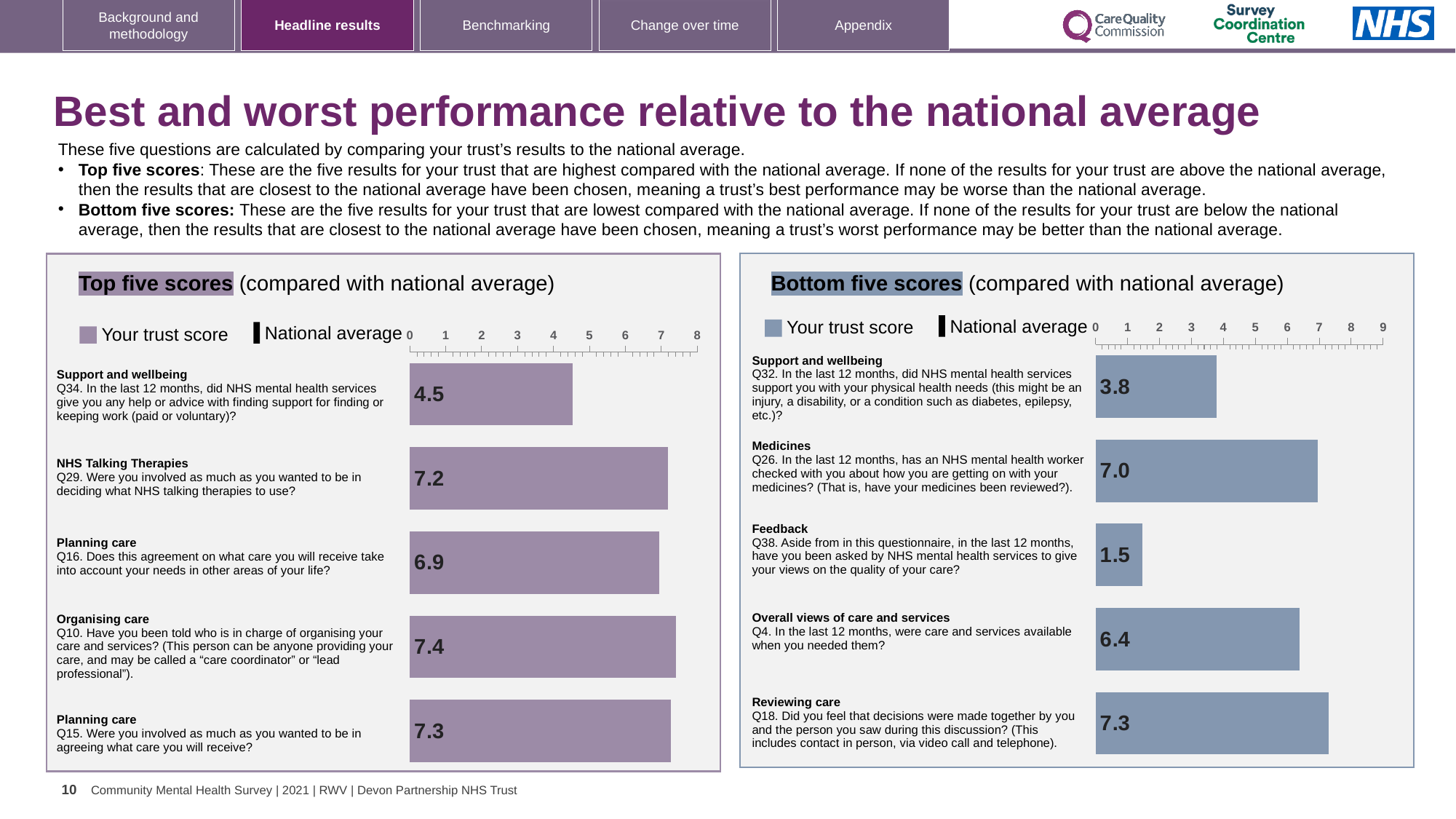
In the Top five scores chart, which question has the lowest trust score? Q34 (Support and wellbeing) In the Bottom five scores chart, which question has the highest trust score? Q18 (Reviewing care) What type of chart is the Top five scores chart? Bar chart In the Bottom five scores chart, what is the trust score for Q38 (Feedback)? 1.5 In the Top five scores chart, what is the trust score for Q34 (Support and wellbeing)? 4.5 In the Top five scores chart, what is the difference between the trust scores for Q10 and Q34? 2.9 In the Top five scores chart, what is the trust score for Q10 (Organising care)? 7.4 In the Bottom five scores chart, which question has the lowest trust score? Q38 (Feedback) In the Top five scores chart, which question has the highest trust score? Q10 (Organising care) In the Bottom five scores chart, which has the larger trust score, Q32 (Support and wellbeing) or Q4 (Overall views of care and services)? Q4 (Overall views of care and services) In the Bottom five scores chart, what is the trust score for Q26 (Medicines)? 7.0 How many questions are shown in the Bottom five scores chart? 5